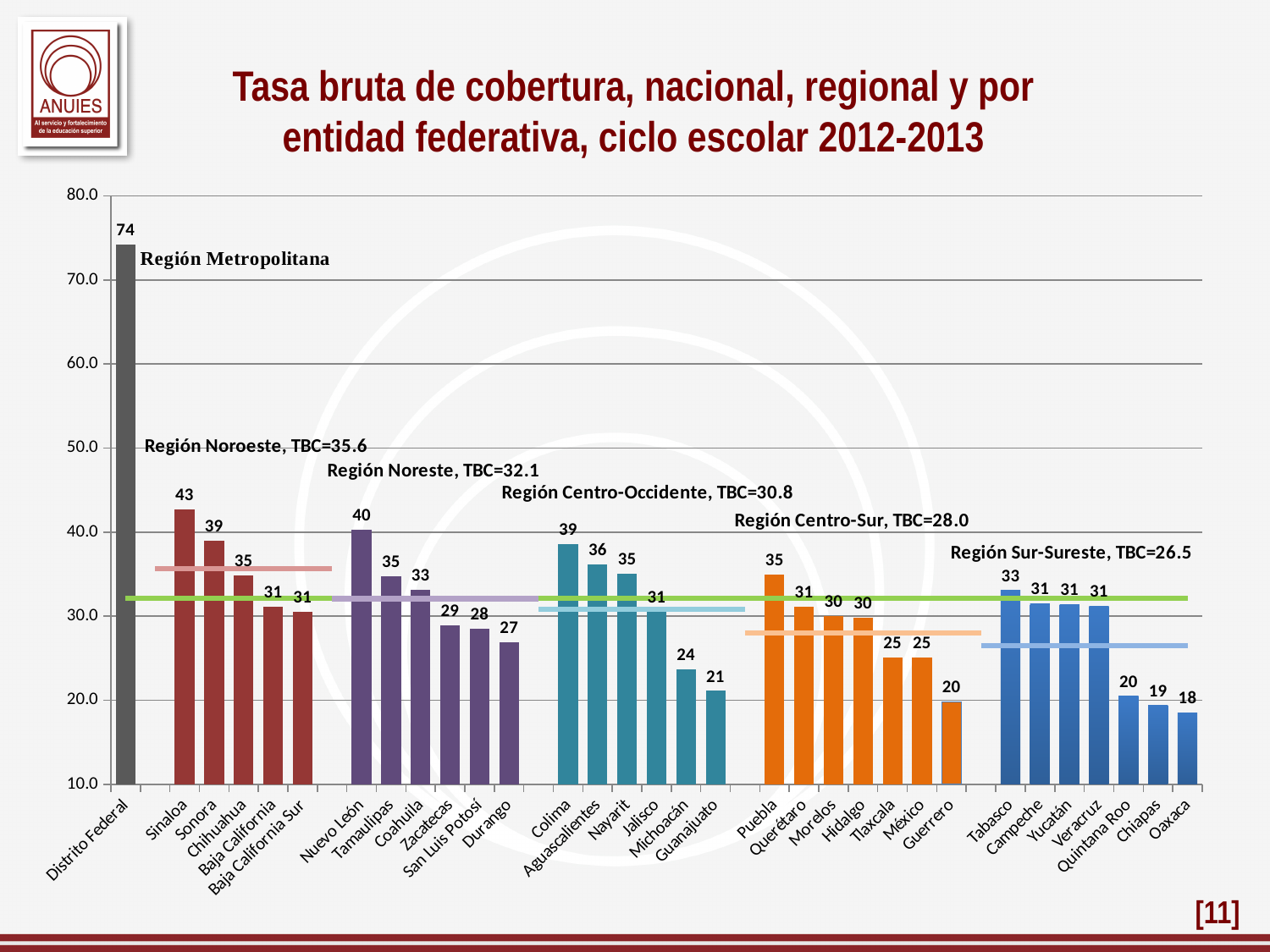
How many entities (bars) are plotted on the chart? 32 Which entity has the highest value on the chart? Distrito Federal What is the value shown for Distrito Federal? 74 What is the difference between the values for Sinaloa and Guerrero? 23 What is the title of the chart? Tasa bruta de cobertura, nacional, regional y por entidad federativa, ciclo escolar 2012-2013 Which has a larger value, Colima or Puebla? Colima What kind of chart is shown on the slide? bar chart What TBC value is given for Región Centro-Sur? 28.0 Is the value for Michoacán greater or less than 30.0? less Which entity has the lowest value on the chart? Oaxaca What is the value shown for Oaxaca? 18 What is the value shown for Nuevo León? 40